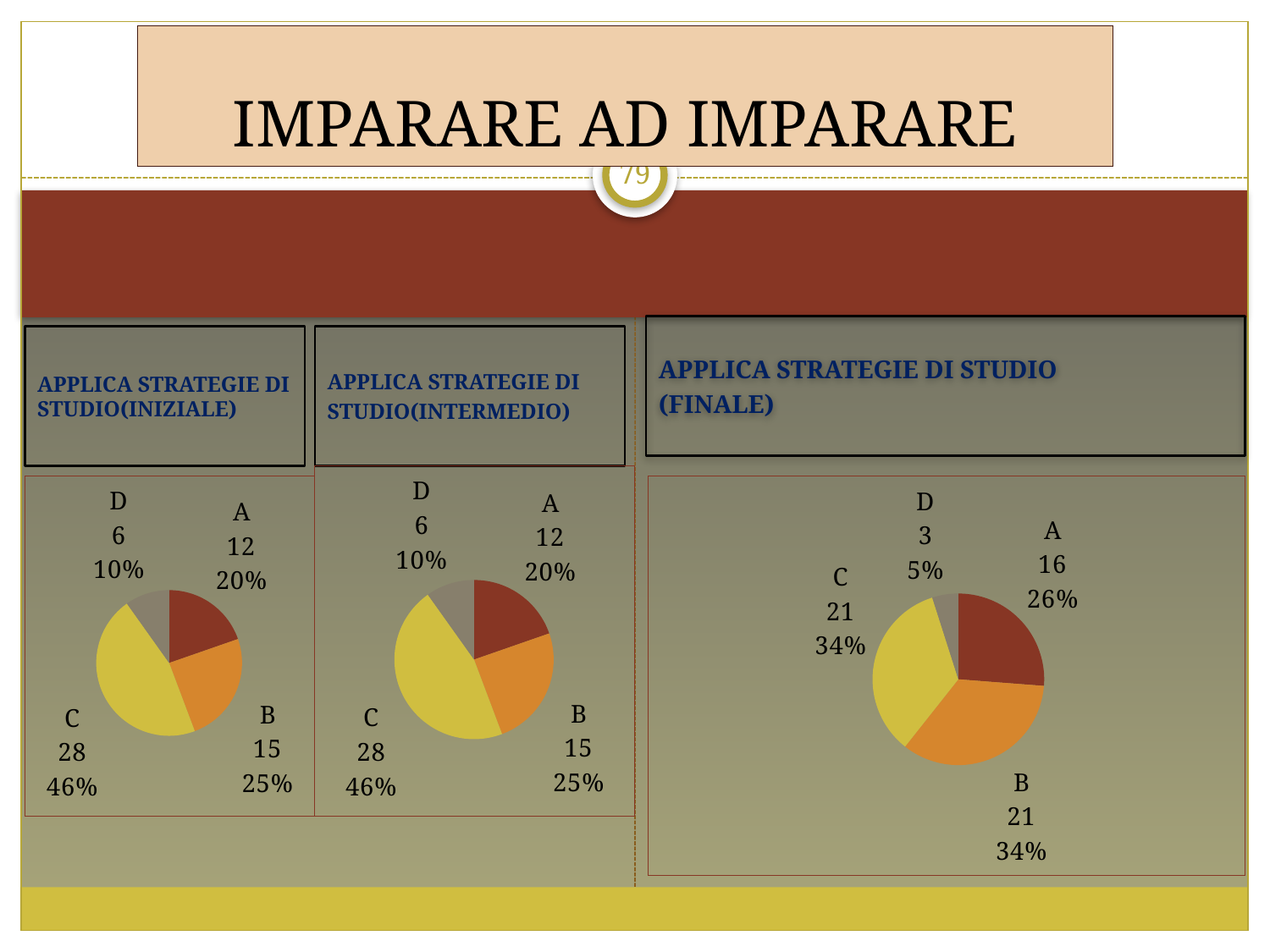
How many pie charts are shown on the slide? 3 In the 'APPLICA STRATEGIE DI STUDIO (FINALE)' chart, what is the value for category D? 3 In the 'APPLICA STRATEGIE DI STUDIO (INIZIALE)' chart, which category has the smallest slice? D In the 'APPLICA STRATEGIE DI STUDIO (INIZIALE)' chart, what is the value for category C? 28 In the 'APPLICA STRATEGIE DI STUDIO (INTERMEDIO)' chart, which category has the largest slice? C In the 'APPLICA STRATEGIE DI STUDIO (INTERMEDIO)' chart, what is the value for category A? 12 In the 'APPLICA STRATEGIE DI STUDIO (INIZIALE)' chart, what share of the pie does category B represent? 25% In the 'APPLICA STRATEGIE DI STUDIO (FINALE)' chart, what share of the pie does category A represent? 26% How many categories are shown in the 'APPLICA STRATEGIE DI STUDIO (FINALE)' chart? 4 In the 'APPLICA STRATEGIE DI STUDIO (FINALE)' chart, which is larger, the value for A or the value for B? B What type of chart is used in the 'APPLICA STRATEGIE DI STUDIO (INIZIALE)' chart? pie chart In the 'APPLICA STRATEGIE DI STUDIO (INTERMEDIO)' chart, what is the difference between the values for C and D? 22